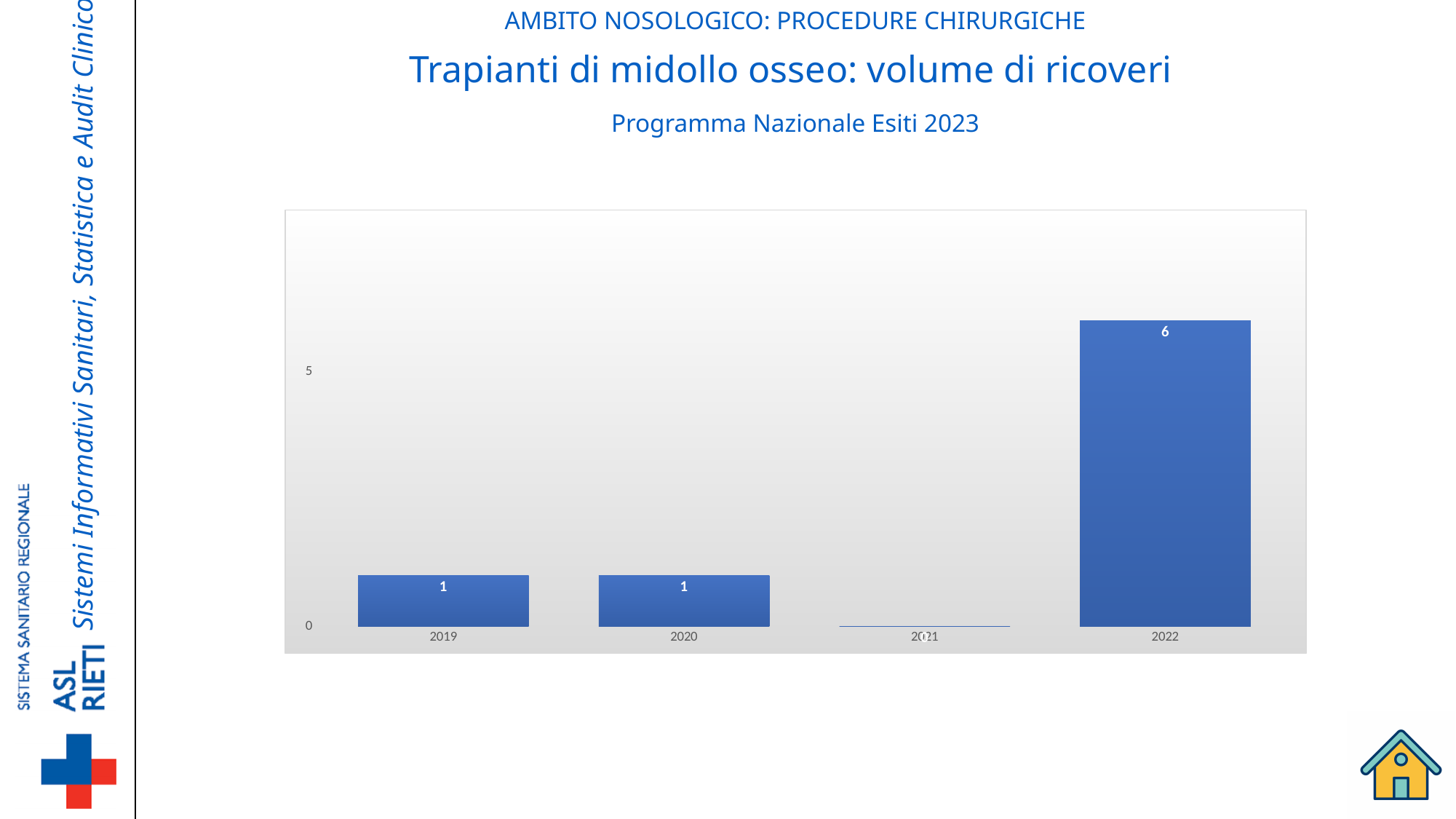
What is the difference between the values for 2022 and 2019? 5 What is the value for 2022? 6 Is the value for 2022 greater or less than 5? greater Which year has the lowest value? 2021 Which is larger, the value for 2022 or the value for 2020? 2022 What is the value for 2020? 1 Which year has the highest value? 2022 What kind of chart is shown on the slide? bar chart How many years are shown on the x axis? 4 What is the value for 2019? 1 Is the value for 2019 greater or less than 5? less What is the main title of the slide above the chart? Trapianti di midollo osseo: volume di ricoveri